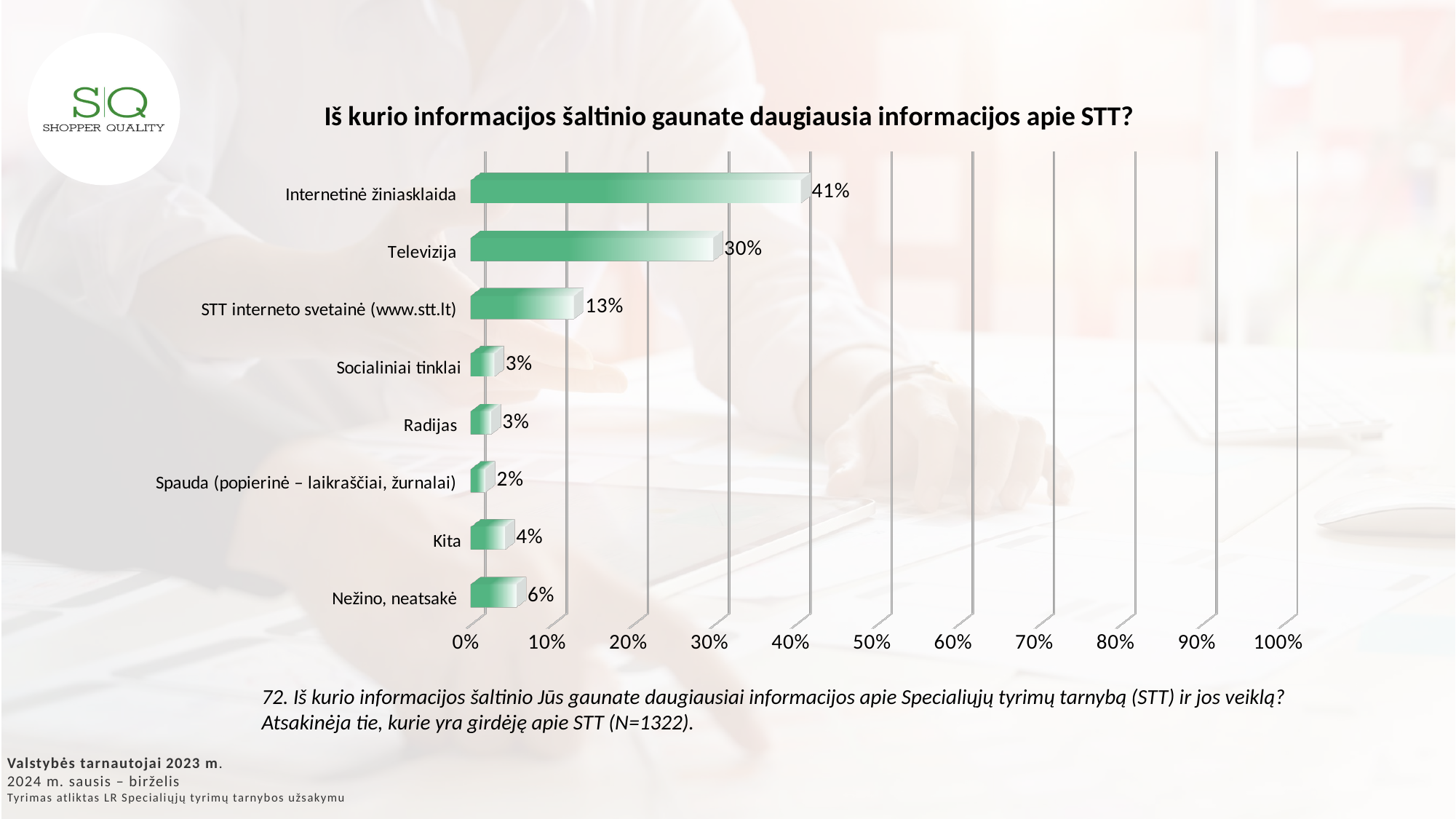
What is the value for Internetinė žiniasklaida? 41% What is the title of the chart? Iš kurio informacijos šaltinio gaunate daugiausia informacijos apie STT? Which category has the lowest value? Spauda (popierinė – laikraščiai, žurnalai) Is the value for Televizija greater or less than 20%? greater What kind of chart is shown on the slide? bar chart Which is larger, the value for Kita or the value for Radijas? Kita How many categories are shown in the chart? 8 What is the value for Televizija? 30% What is the difference between the values for Internetinė žiniasklaida and Televizija? 11% Which category has the highest value? Internetinė žiniasklaida What is the value for Nežino, neatsakė? 6% What is the value for STT interneto svetainė (www.stt.lt)? 13%